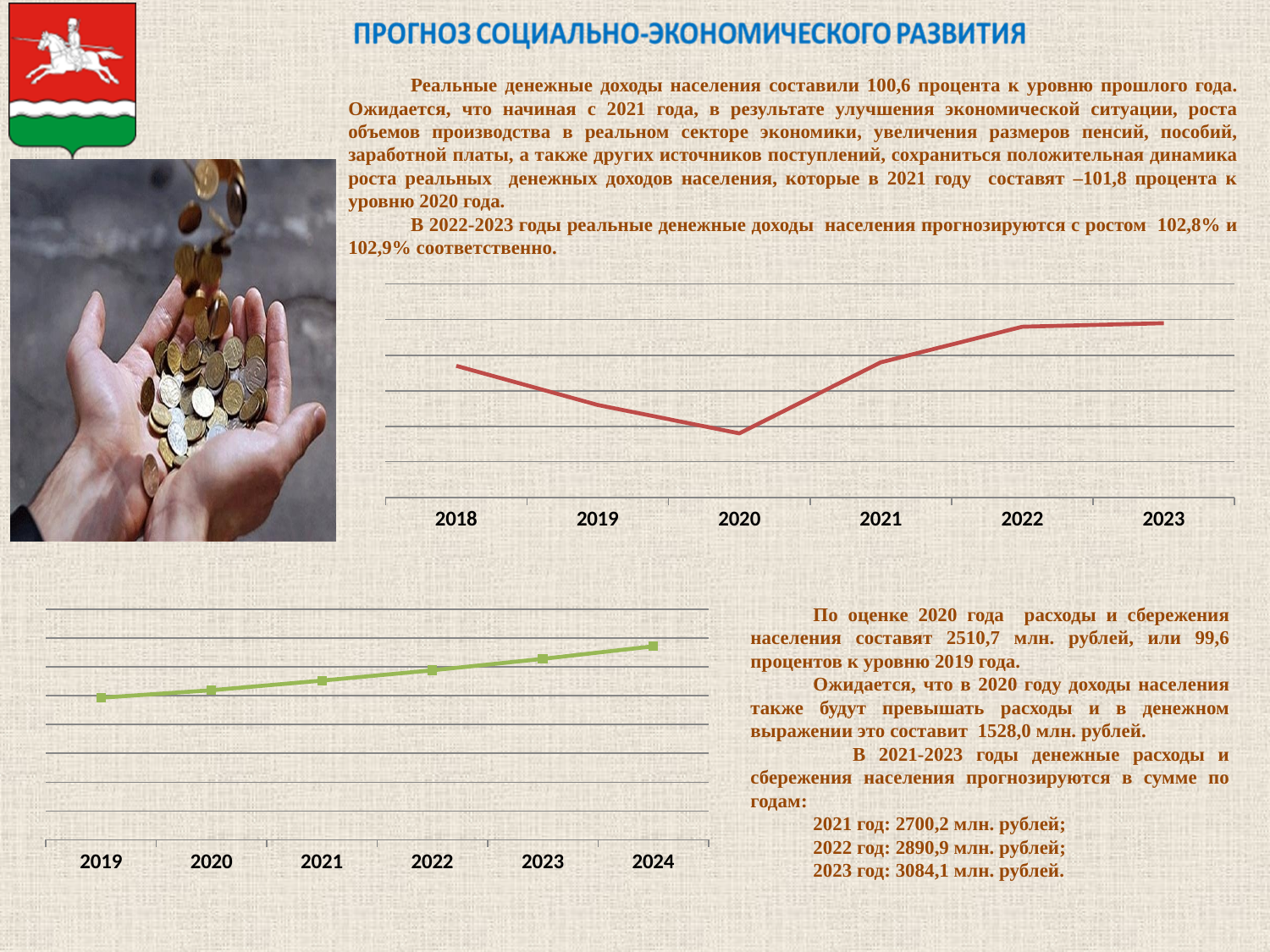
In the top chart, which is larger, the value for 2019 or the value for 2021? 2021 In the bottom-left chart, which year has the highest value? 2024 In the top chart, do the values rise or fall from 2020 to 2023? rise In the bottom-left chart, do the values rise or fall from 2019 to 2024? rise In the top chart, which year has the lowest value? 2020 In the top chart, is the value for 2018 larger or smaller than the value for 2020? larger In the bottom-left chart, how many years are shown on the x axis? 6 In the top chart, how many years are shown on the x axis? 6 In the bottom-left chart, which year has the lowest value? 2019 What kind of chart is the top chart on the slide? line chart What kind of chart is the bottom-left chart on the slide? line chart In the top chart, do the values rise or fall from 2018 to 2020? fall